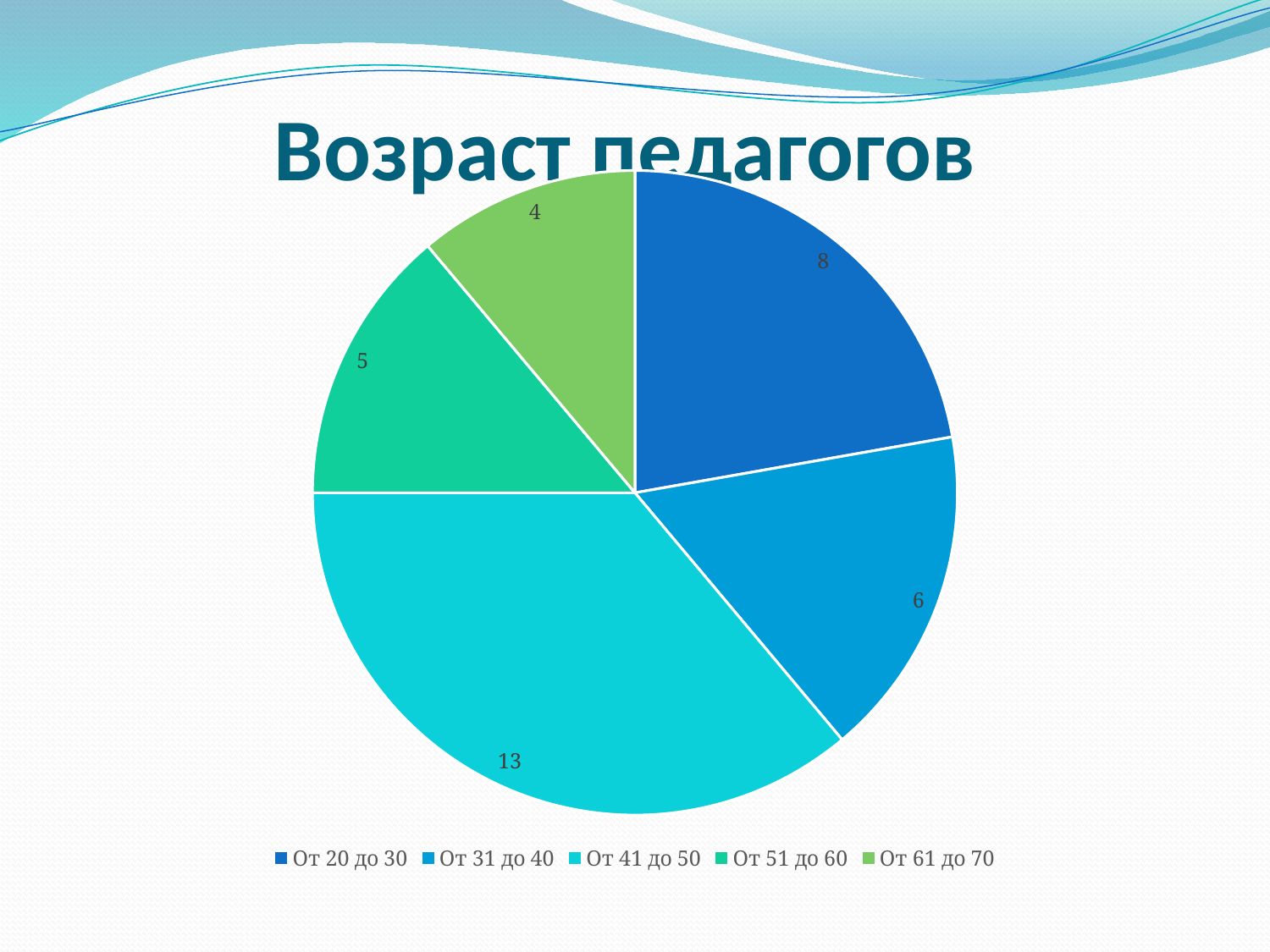
Which age group has the largest slice? От 41 до 50 What kind of chart is shown on the slide? pie chart What is the total of all the slice values in the pie chart? 36 What is the value for the slice "От 61 до 70"? 4 What is the value for the slice "От 41 до 50"? 13 What is the title of the chart? Возраст педагогов How many slices does the pie chart have? 5 What is the value for the slice "От 51 до 60"? 5 Which age group has the smallest slice? От 61 до 70 What is the difference between the values for "От 41 до 50" and "От 31 до 40"? 7 What is the value for the slice "От 20 до 30"? 8 Which is larger, the value for "От 20 до 30" or the value for "От 31 до 40"? От 20 до 30